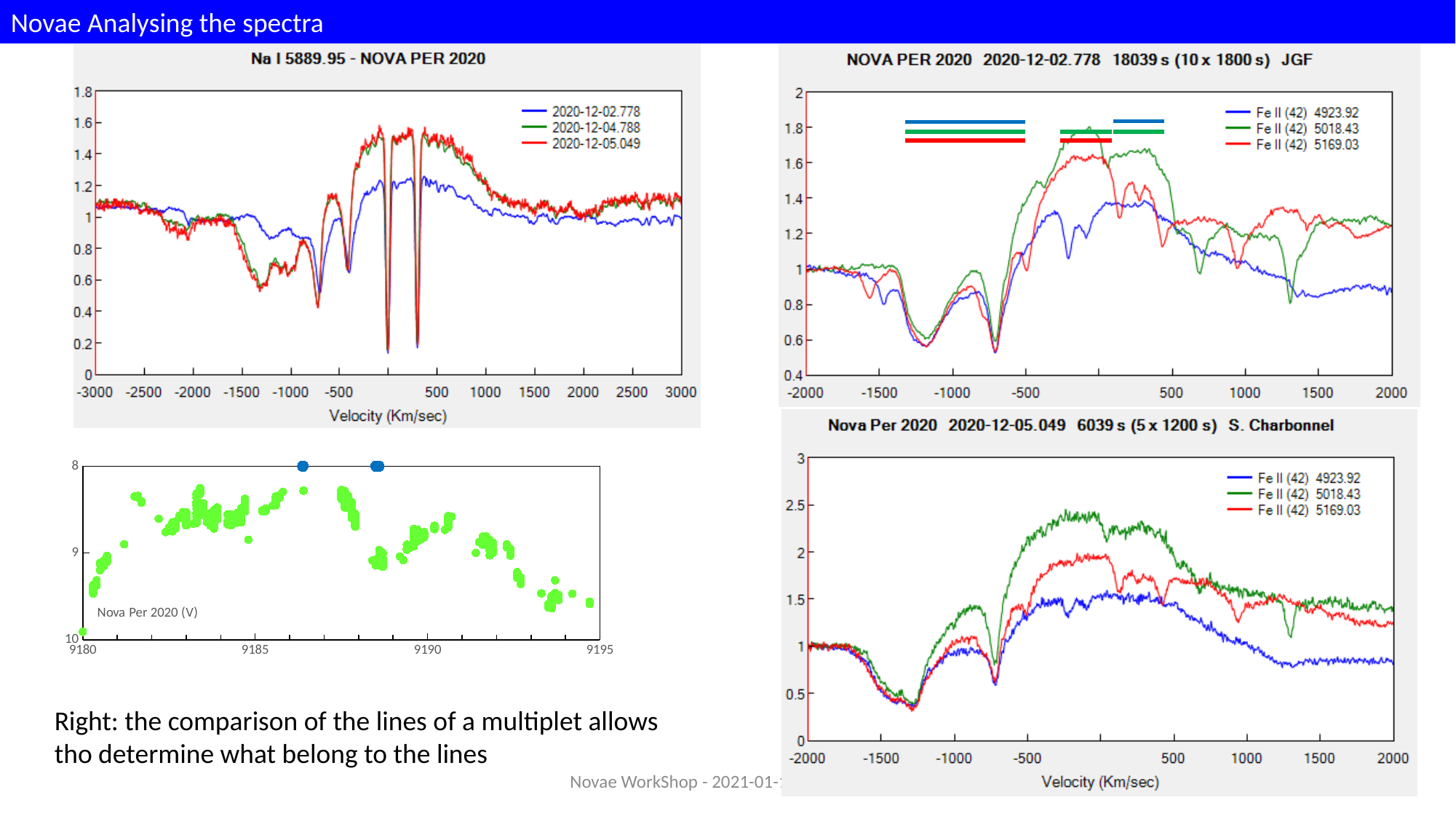
What is the x-axis label of the top-left chart titled 'Na I 5889.95 - NOVA PER 2020'? Velocity (Km/sec) How many series does the legend of the top-left chart titled 'Na I 5889.95 - NOVA PER 2020' list? 3 In the top-left chart titled 'Na I 5889.95 - NOVA PER 2020', which date does the blue line represent according to the legend? 2020-12-02.778 How many series does the legend of the top-right chart titled 'NOVA PER 2020 2020-12-02.778 18039 s (10 x 1800 s) JGF' list? 3 In the top-right chart titled 'NOVA PER 2020 2020-12-02.778 18039 s (10 x 1800 s) JGF', which Fe II line does the green series represent? Fe II (42) 5018.43 In the top-left chart titled 'Na I 5889.95 - NOVA PER 2020', is the minimum value of the red series greater or less than 0.4? less What kind of chart is the top-left chart titled 'Na I 5889.95 - NOVA PER 2020'? line chart What kind of chart is the bottom-left chart labelled 'Nova Per 2020 (V)'? scatter chart In the bottom-left chart labelled 'Nova Per 2020 (V)', do the plotted points generally rise or fall along the x axis from 9188 to 9195? fall In the bottom-right chart titled 'Nova Per 2020 2020-12-05.049 6039 s (5 x 1200 s) S. Charbonnel', which series reaches the highest peak: the green or the blue? green In the bottom-right chart titled 'Nova Per 2020 2020-12-05.049 6039 s (5 x 1200 s) S. Charbonnel', is the peak value of the green series greater or less than 2? greater In the bottom-right chart titled 'Nova Per 2020 2020-12-05.049 6039 s (5 x 1200 s) S. Charbonnel', is the value of the blue series at velocity 2000 Km/sec greater or less than 1? less